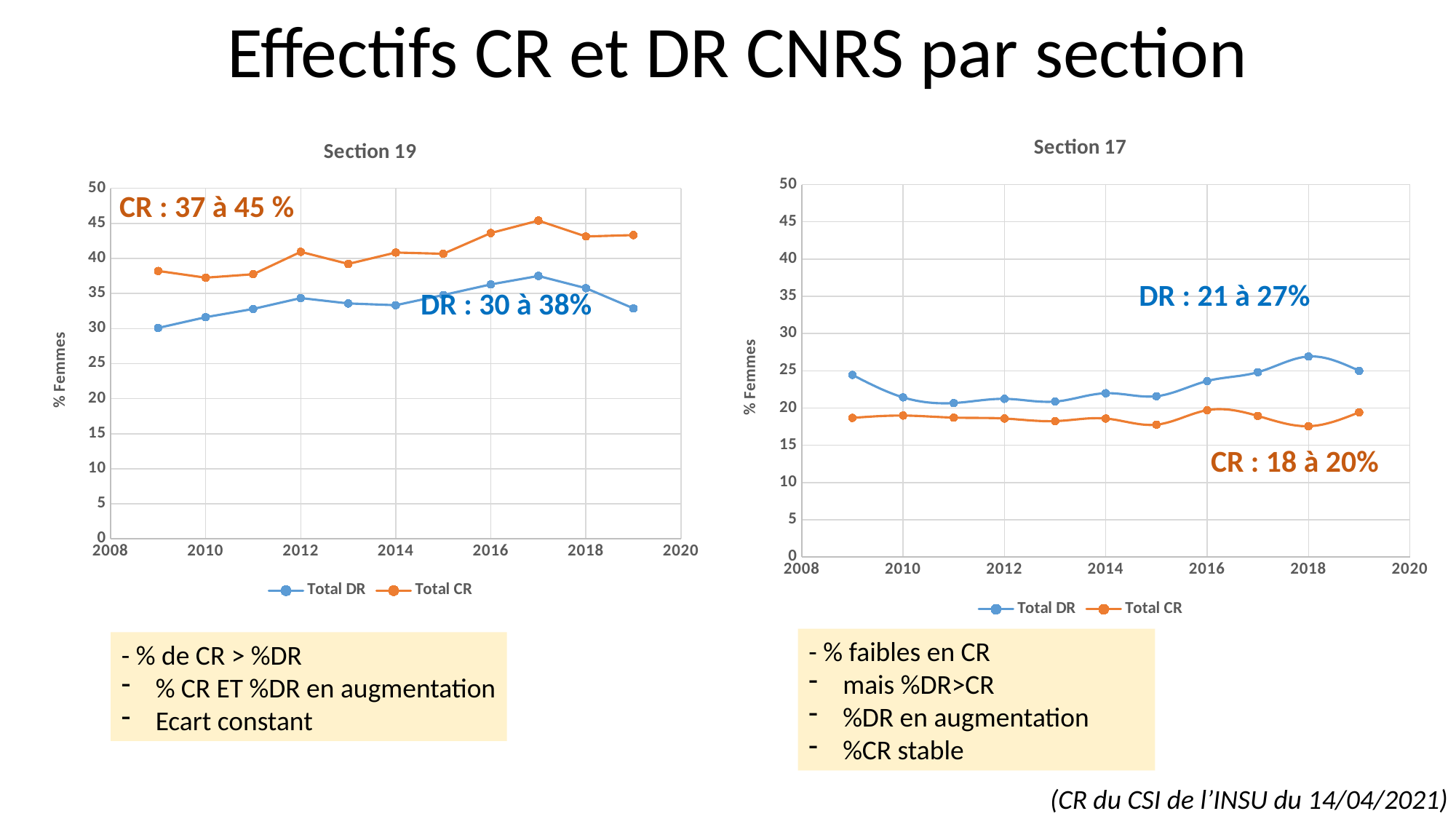
In the Section 17 chart, which series has the larger value in 2018, Total DR or Total CR? Total DR In the Section 19 chart, in which year is the Total DR series at its lowest? 2009 In the Section 17 chart, is the Total CR value for 2009 greater or less than 20? less How many series does the legend of the Section 17 chart list? 2 In the Section 19 chart, is the Total DR value for 2009 greater or less than 35? less What kind of chart is the Section 19 chart? line chart In the Section 17 chart, in which year does the Total DR series reach its highest value? 2018 In the Section 19 chart, which series has the larger value in 2012, Total DR or Total CR? Total CR What is the y-axis label of the Section 19 chart? % Femmes In the Section 19 chart, in which year does the Total CR series reach its highest value? 2017 In the Section 19 chart, is the Total CR value for 2017 greater or less than 40? greater How many data points does the Total DR series have in the Section 17 chart? 11